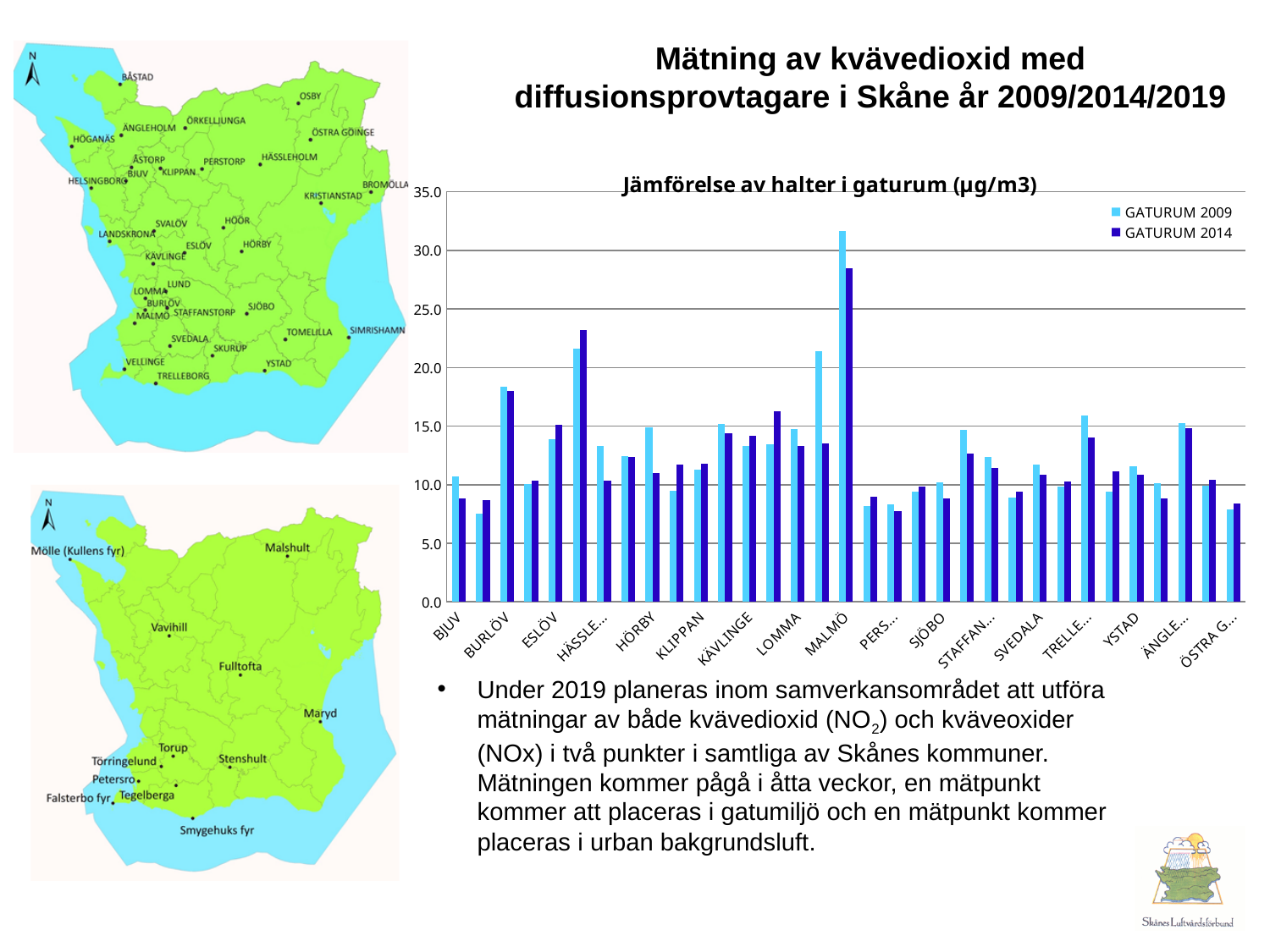
For HÖRBY, which is larger: the GATURUM 2009 value or the GATURUM 2014 value? GATURUM 2009 How many series does the chart legend list? 2 What kind of chart is shown on the slide? bar chart Which category has the highest GATURUM 2009 value? MALMÖ What is the title of the chart? Jämförelse av halter i gaturum (µg/m3) For MALMÖ, which is larger: the GATURUM 2009 value or the GATURUM 2014 value? GATURUM 2009 Is the GATURUM 2009 value for MALMÖ greater or less than 30.0? greater Is the GATURUM 2014 value for MALMÖ greater or less than 30.0? less Is the GATURUM 2009 value for ÖSTRA G... greater or less than 10.0? less Which two series are listed in the chart legend? GATURUM 2009 and GATURUM 2014 Which category has the highest GATURUM 2014 value? MALMÖ